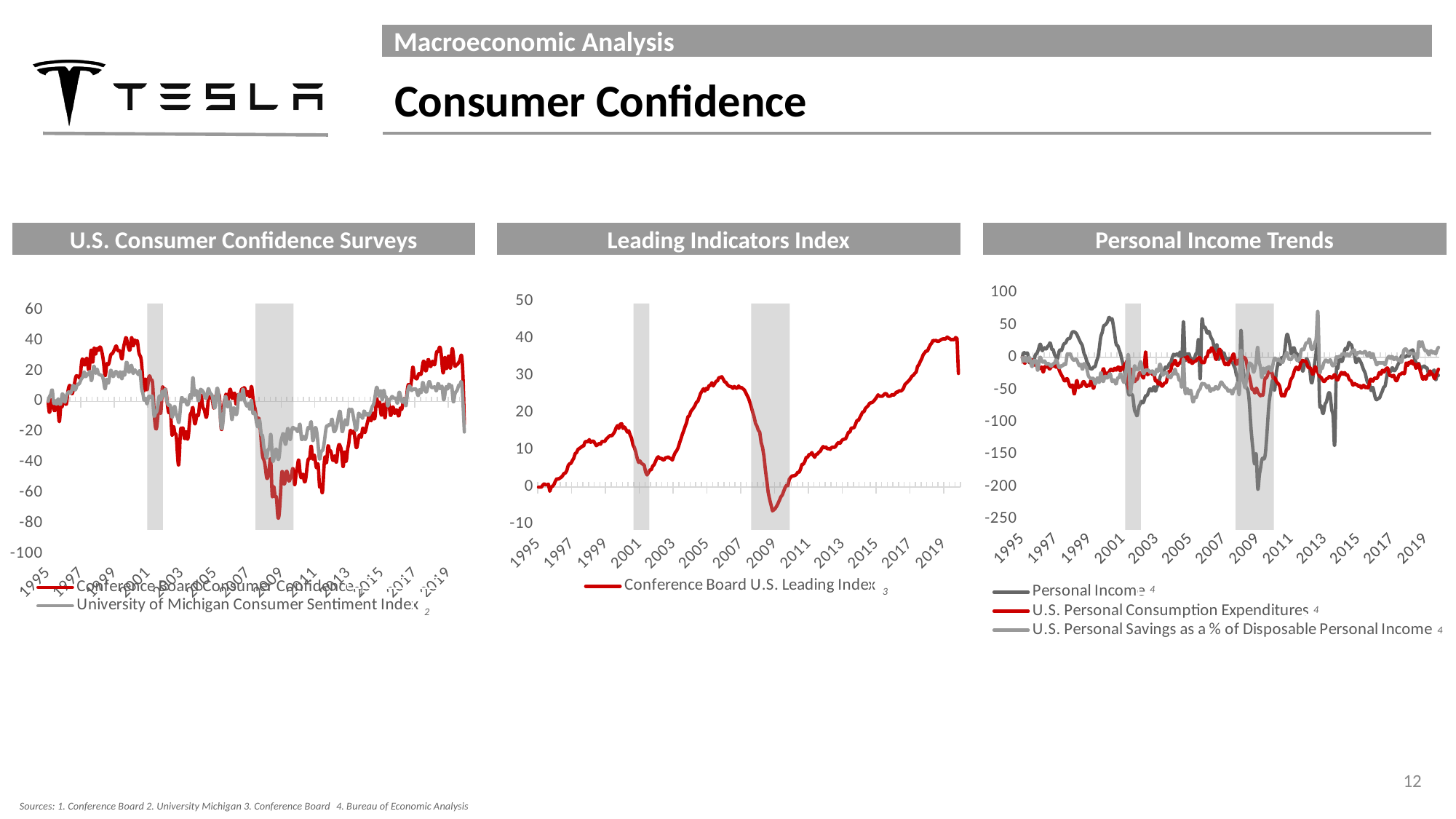
In the 'Leading Indicators Index' chart, is the peak value reached around 2019 greater or less than 30? greater In the 'Personal Income Trends' chart, which series is drawn in red? U.S. Personal Consumption Expenditures In the 'Personal Income Trends' chart, is the lowest value of the Personal Income line (around 2009) greater or less than -150? less How many series does the legend of the 'Personal Income Trends' chart list? 3 In the 'Leading Indicators Index' chart, is the lowest value reached around 2009 greater or less than 0? less How many series does the legend of the 'Leading Indicators Index' chart list? 1 How many year labels are shown on the x axis of the 'Leading Indicators Index' chart? 13 In the 'Leading Indicators Index' chart, does the Conference Board U.S. Leading Index rise or fall between 2010 and 2019? rise In the 'Leading Indicators Index' chart, which peak is higher: the one around 2007 or the one around 2019? the one around 2019 What kind of chart is the 'Leading Indicators Index' chart? line chart How many series does the legend of the 'U.S. Consumer Confidence Surveys' chart list? 2